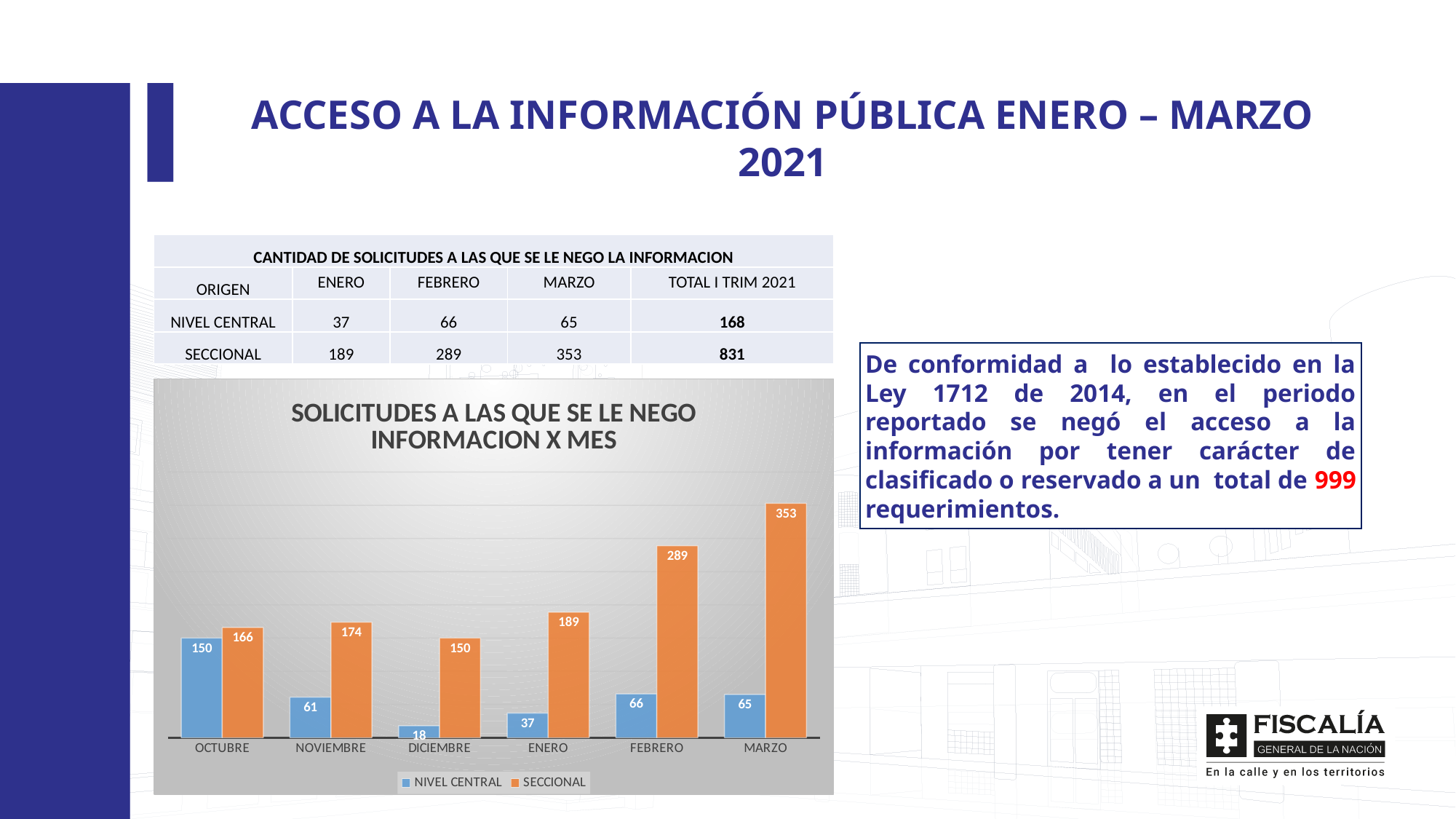
What kind of chart is shown on the slide? Bar chart What is the title of the chart? SOLICITUDES A LAS QUE SE LE NEGO INFORMACION X MES Which is larger in NOVIEMBRE, NIVEL CENTRAL or SECCIONAL? SECCIONAL How many series does the chart legend list? 2 What is the difference between the SECCIONAL and NIVEL CENTRAL values in FEBRERO? 223 What is the value for NIVEL CENTRAL in DICIEMBRE? 18 What is the value for SECCIONAL in MARZO? 353 What is the value for NIVEL CENTRAL in OCTUBRE? 150 Which month has the highest SECCIONAL value? MARZO How many months are shown on the x axis of the chart? 6 Which month has the lowest NIVEL CENTRAL value? DICIEMBRE Do the SECCIONAL values rise or fall from DICIEMBRE to MARZO? Rise